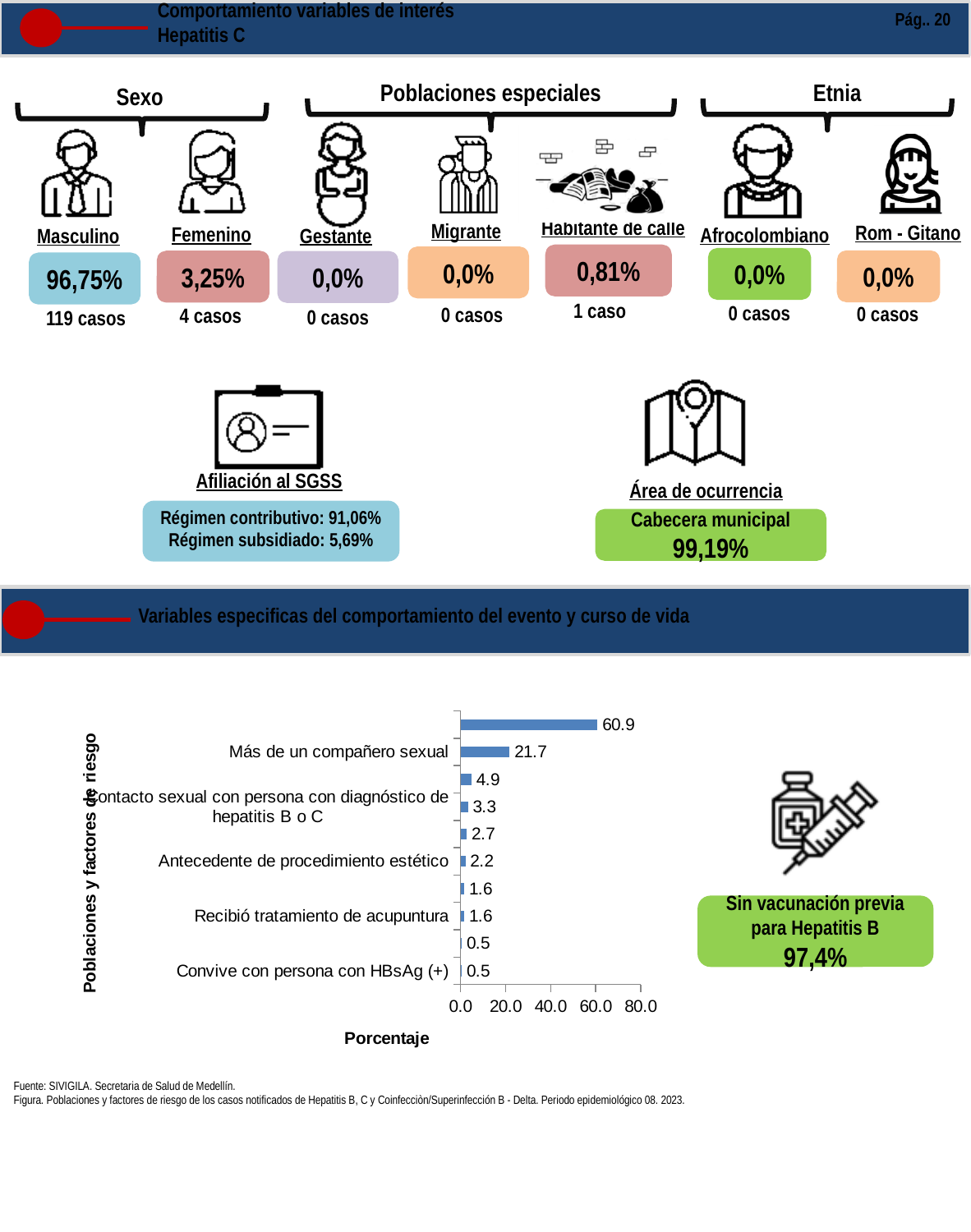
Which has a larger value: 'Antecedente de procedimiento estético' or 'Recibió tratamiento de acupuntura'? Antecedente de procedimiento estético What is the value for 'Antecedente de procedimiento estético' in the bar chart? 2.2 What is the title of the horizontal axis of the bar chart? Porcentaje What is the value for 'Convive con persona con HBsAg (+)' in the bar chart? 0.5 How many bars are plotted in the chart? 10 What is the value for 'Recibió tratamiento de acupuntura' in the bar chart? 1.6 What is the largest value shown on any bar in the chart? 60.9 What kind of chart is shown at the bottom of the slide? Bar chart What is the difference between the values for 'Más de un compañero sexual' and 'Contacto sexual con persona con diagnóstico de hepatitis B o C'? 18.4 What is the value for 'Más de un compañero sexual' in the bar chart? 21.7 Is the value for 'Más de un compañero sexual' greater or less than 40.0? less What is the value for 'Contacto sexual con persona con diagnóstico de hepatitis B o C' in the bar chart? 3.3